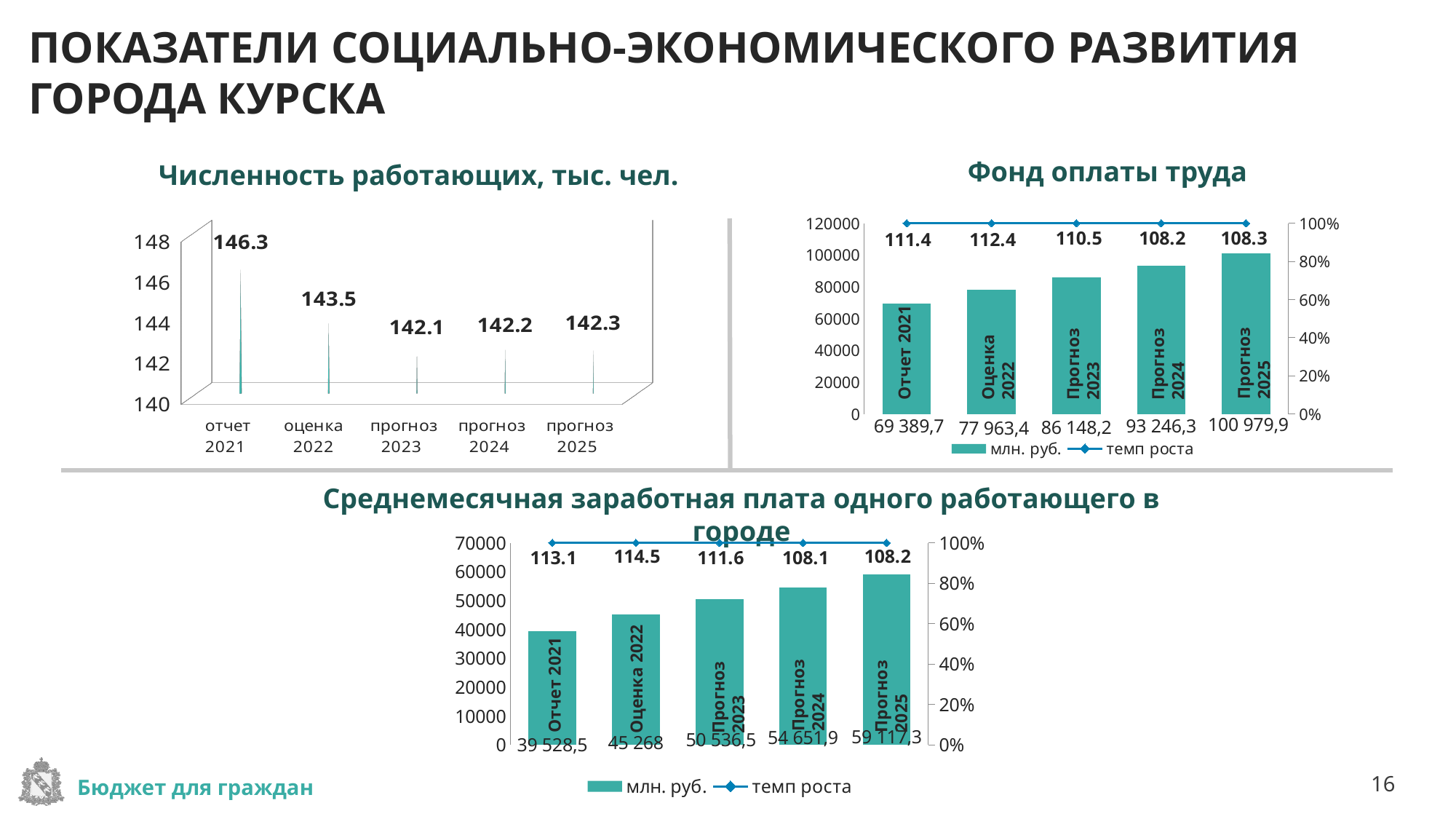
In the chart 'Среднемесячная заработная плата одного работающего в городе', what is the value in млн. руб. for Оценка 2022? 45 268 In the chart 'Фонд оплаты труда', do the bar values rise or fall from Отчет 2021 to Прогноз 2025? rise In the chart 'Численность работающих, тыс. чел.', what is the difference between the values for отчет 2021 and оценка 2022? 2.8 In the chart 'Фонд оплаты труда', how many series does the legend list? 2 In the chart 'Численность работающих, тыс. чел.', what is the value for отчет 2021? 146.3 In the chart 'Фонд оплаты труда', what is the value in млн. руб. for Прогноз 2025? 100 979,9 In the chart 'Фонд оплаты труда', what is the темп роста value for Оценка 2022? 112.4 In the chart 'Среднемесячная заработная плата одного работающего в городе', is the темп роста value for Прогноз 2023 larger or smaller than that for Прогноз 2024? larger In the chart 'Численность работающих, тыс. чел.', which category has the lowest value? прогноз 2023 In the chart 'Среднемесячная заработная плата одного работающего в городе', how many categories are shown on the x axis? 5 In the chart 'Фонд оплаты труда', what is the difference in млн. руб. between Прогноз 2025 and Отчет 2021? 31 590,2 In the chart 'Среднемесячная заработная плата одного работающего в городе', which category has the highest темп роста value? Оценка 2022